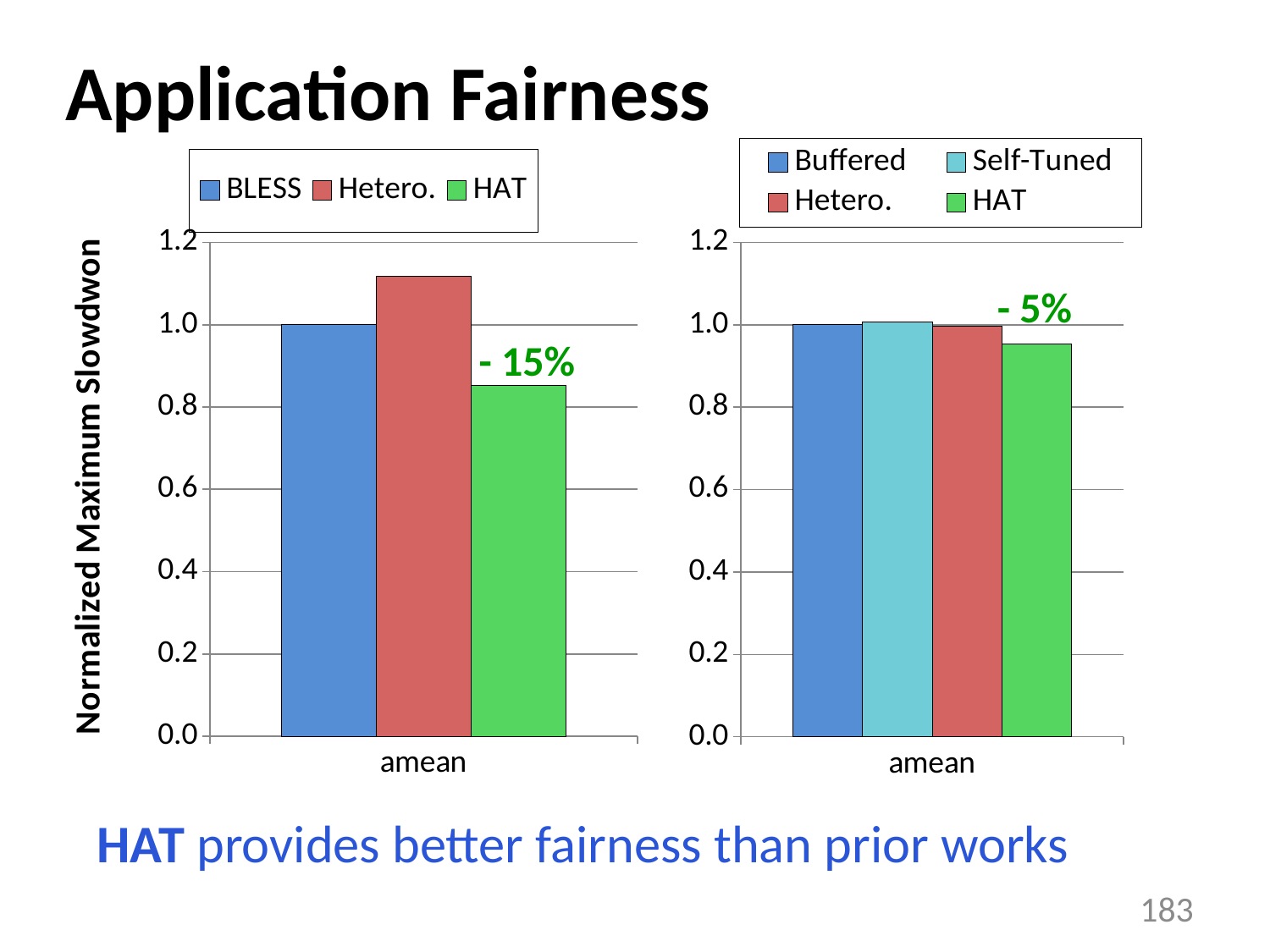
What kind of chart is the left chart? bar chart How many categories are shown on the x axis of the right chart? 1 In the left chart, which is larger, the value for BLESS or the value for HAT? BLESS How many series does the legend of the left chart list? 3 In the left chart, which series has the highest normalized maximum slowdown? Hetero. In the right chart, is the value for HAT greater or less than 1.0? less In the right chart, which series has the lowest normalized maximum slowdown? HAT How many series does the legend of the right chart list? 4 What percentage annotation is printed next to the HAT bar in the left chart? - 15% In the left chart, which series has the lowest normalized maximum slowdown? HAT In the left chart, is the value for HAT greater or less than 1.0? less In the left chart, is the value for Hetero. greater or less than 1.0? greater